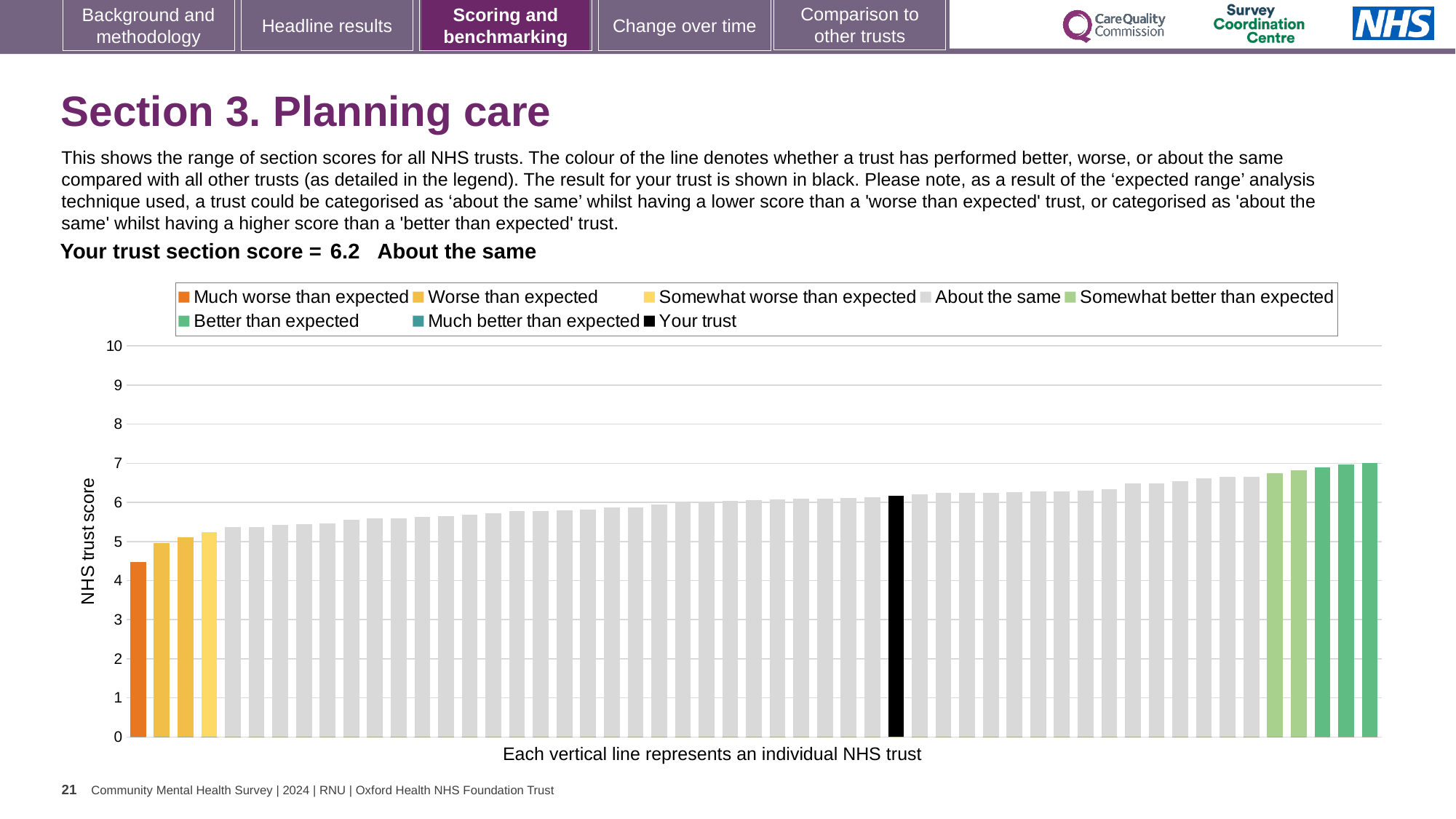
What is the label on the vertical axis of the chart? NHS trust score Which performance category is your trust placed in for Section 3. Planning care? About the same Is the value of the lowest bar (the orange 'Much worse than expected' trust) greater or less than 5? less Is the value of the highest bar on the chart greater or less than 8? less Is the value of the highest bar on the chart greater or less than 6? greater How many entries does the chart legend list? 8 Do the bar values rise or fall from left to right across the chart? rise What is the section score for your trust shown on the slide? 6.2 What kind of chart is shown on the slide? bar chart What colour is the bar representing your trust? black How many bars are coloured orange ('Much worse than expected')? 1 Which is larger: the score for your trust (black bar) or the score of the leftmost orange bar? your trust